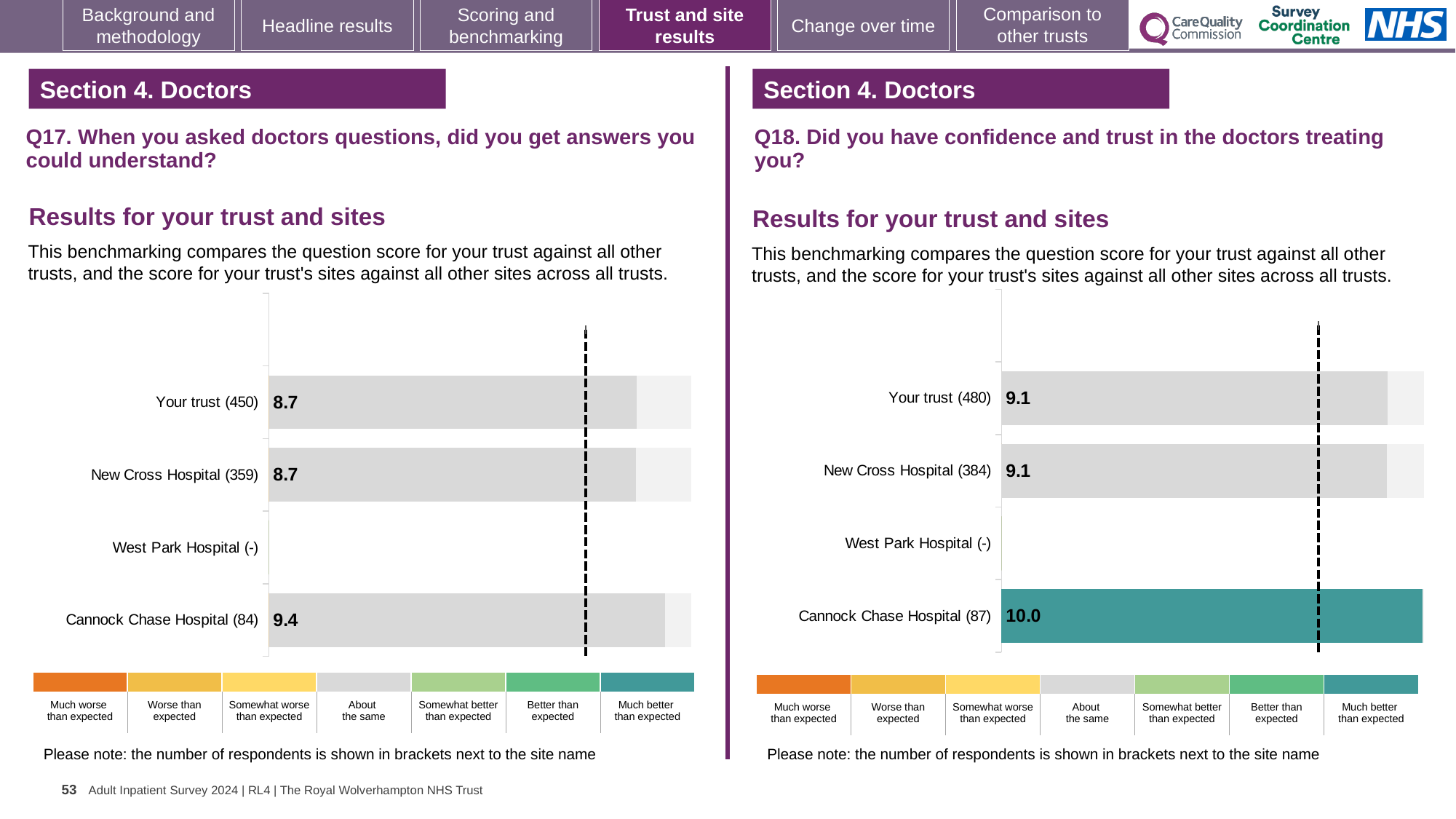
In the Q17 chart on the left, which site has the highest score? Cannock Chase Hospital (84) In the Q18 chart on the right, what is the difference between the scores for Cannock Chase Hospital (87) and Your trust (480)? 0.9 In the Q17 chart on the left, what is the score for Cannock Chase Hospital (84)? 9.4 In the Q18 chart on the right, which benchmark category does the colour of the Cannock Chase Hospital (87) bar correspond to in the legend? Much better than expected In the Q18 chart on the right, what is the score for New Cross Hospital (384)? 9.1 How many site/trust rows are listed in the Q17 chart on the left? 4 In the Q18 chart on the right, is the score for Cannock Chase Hospital (87) larger or smaller than the score for New Cross Hospital (384)? larger In the Q18 chart on the right, what is the score for Cannock Chase Hospital (87)? 10.0 In the Q17 chart on the left, what is the score for Your trust (450)? 8.7 In the Q18 chart on the right, which site has the highest score? Cannock Chase Hospital (87) What kind of chart is used for the Q18 results on the right? bar chart In the Q17 chart on the left, what is the difference between the scores for Cannock Chase Hospital (84) and New Cross Hospital (359)? 0.7